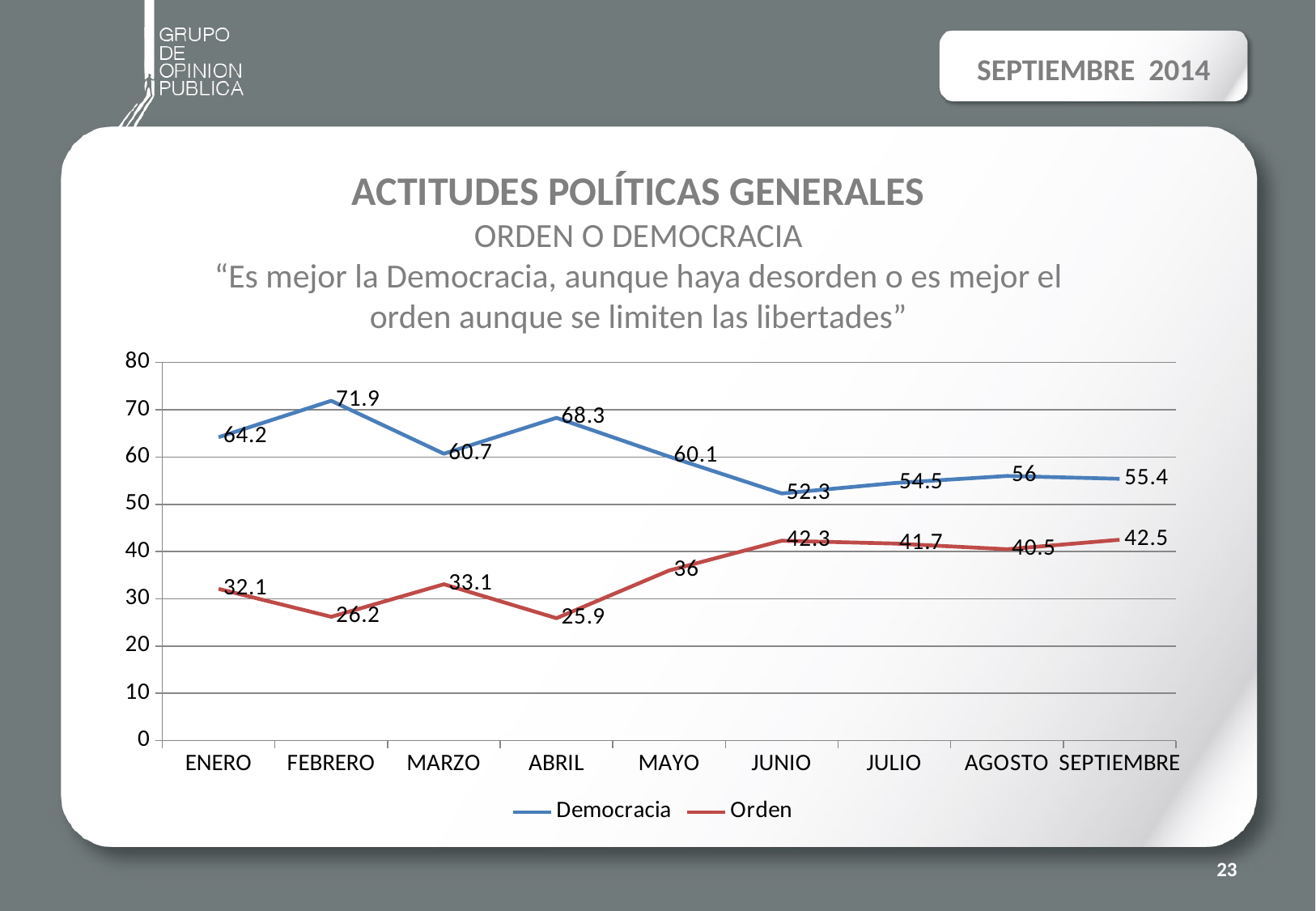
How many months are shown on the x axis? 9 What kind of chart is shown? line chart What is the value for Orden in ABRIL? 25.9 How many series does the legend list? 2 Is the value for Democracia in ENERO greater or less than 60? greater What is the value for Democracia in FEBRERO? 71.9 In which month is the Democracia series highest? FEBRERO Does the Orden series rise or fall from ABRIL to JUNIO? rise Which is larger in MAYO, Democracia or Orden? Democracia What is the difference between Democracia and Orden in JUNIO? 10 In which month is the Orden series lowest? ABRIL What is the value for Orden in SEPTIEMBRE? 42.5